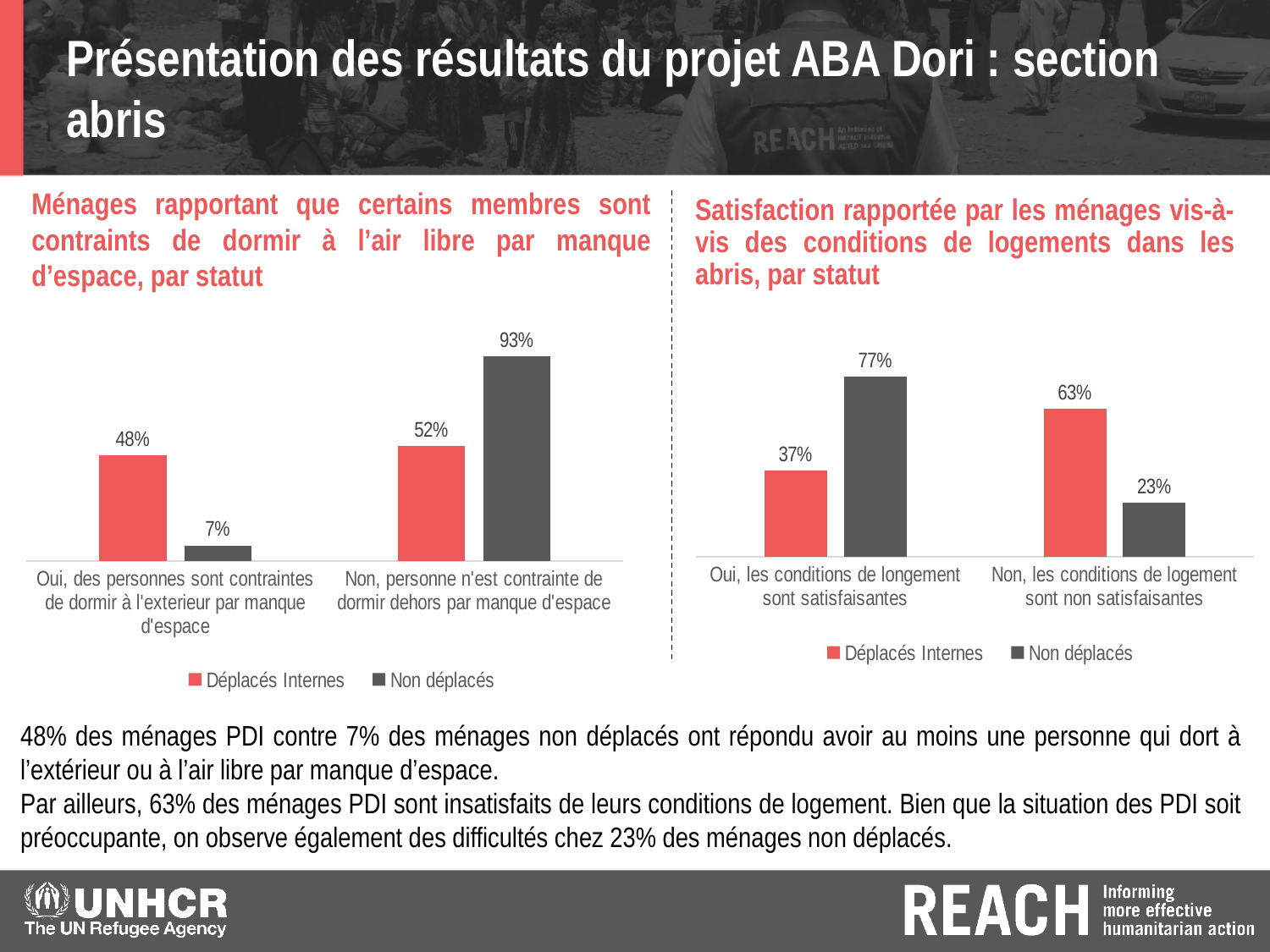
In the left chart (sleeping outdoors due to lack of space), what is the value for Déplacés Internes in the 'Oui' category? 48% In the right chart (satisfaction with housing conditions), what is the difference between the Non déplacés and Déplacés Internes values in the 'Oui' category? 40 percentage points In the right chart (satisfaction with housing conditions), what is the value for Non déplacés in the 'Oui, les conditions de longement sont satisfaisantes' category? 77% In the right chart (satisfaction with housing conditions), which bar is the lowest? Non déplacés, Non (23%) In the left chart (sleeping outdoors due to lack of space), what is the value for Non déplacés in the 'Non' category? 93% What type of chart is the right chart (satisfaction with housing conditions)? Bar chart In the left chart (sleeping outdoors due to lack of space), which series has the higher value in the 'Non' category? Non déplacés In the right chart (satisfaction with housing conditions), what is the value for Déplacés Internes in the 'Non, les conditions de logement sont non satisfaisantes' category? 63% In the left chart (sleeping outdoors due to lack of space), what is the difference between the Déplacés Internes and Non déplacés values in the 'Oui' category? 41 percentage points In the left chart (sleeping outdoors due to lack of space), how many series does the legend list? 2 In the right chart (satisfaction with housing conditions), how many categories are shown on the x axis? 2 In the left chart (sleeping outdoors due to lack of space), what colour represents Déplacés Internes? Red